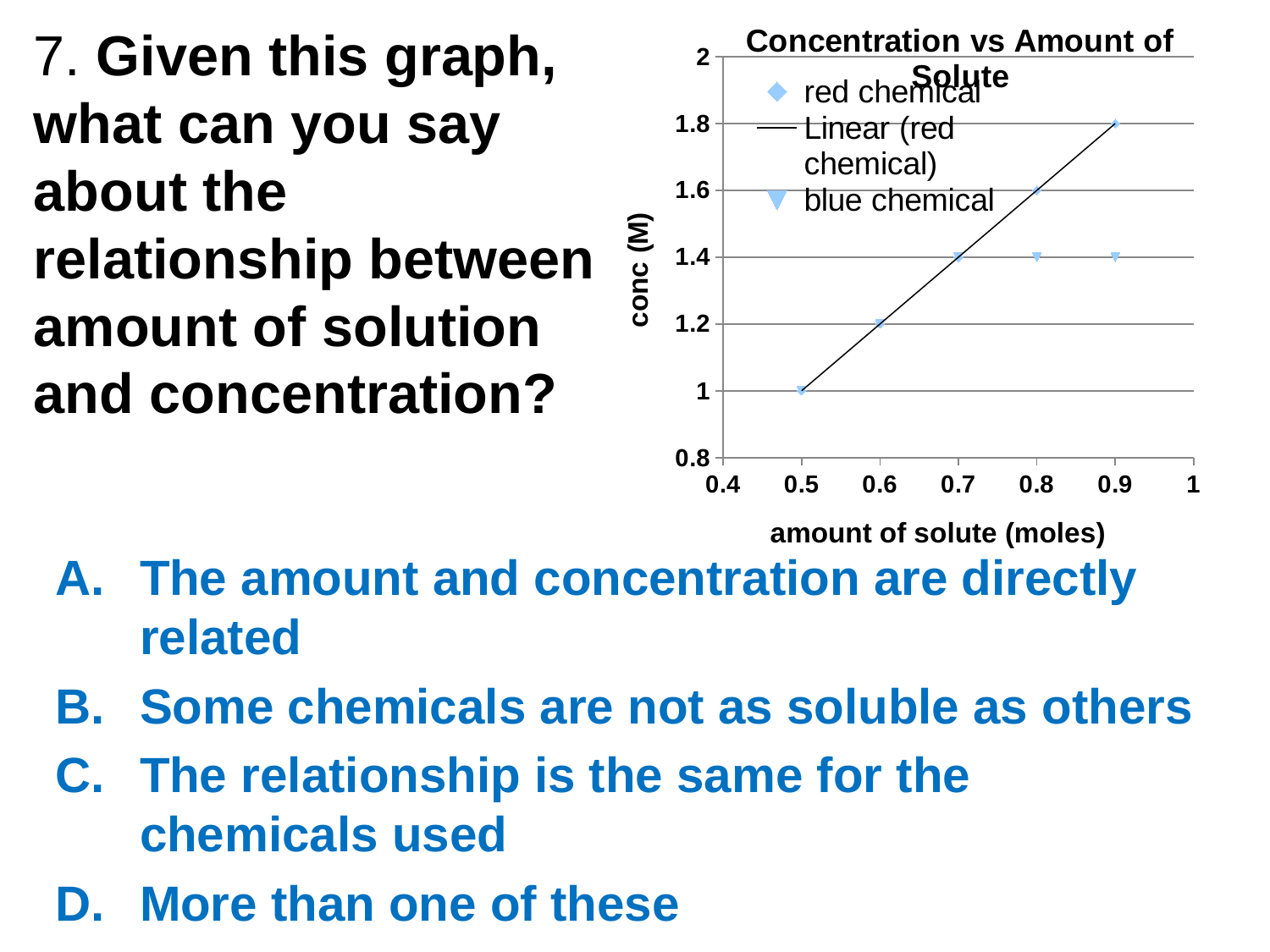
What is the concentration of the blue chemical at 0.8 moles of solute? 1.4 How many entries does the chart's legend list? 3 What is the concentration of the red chemical at 0.9 moles of solute? 1.8 Does the concentration of the red chemical rise or fall as the amount of solute increases? rise How many data points are plotted for the red chemical? 5 What is the title of the chart? Concentration vs Amount of Solute What is the difference in concentration between the red chemical and the blue chemical at 0.9 moles of solute? 0.4 What is the concentration of the red chemical at 0.5 moles of solute? 1 What is the label of the y axis? conc (M) At 0.8 moles of solute, which chemical has the higher concentration, red or blue? red chemical What type of chart is shown on the slide? scatter chart